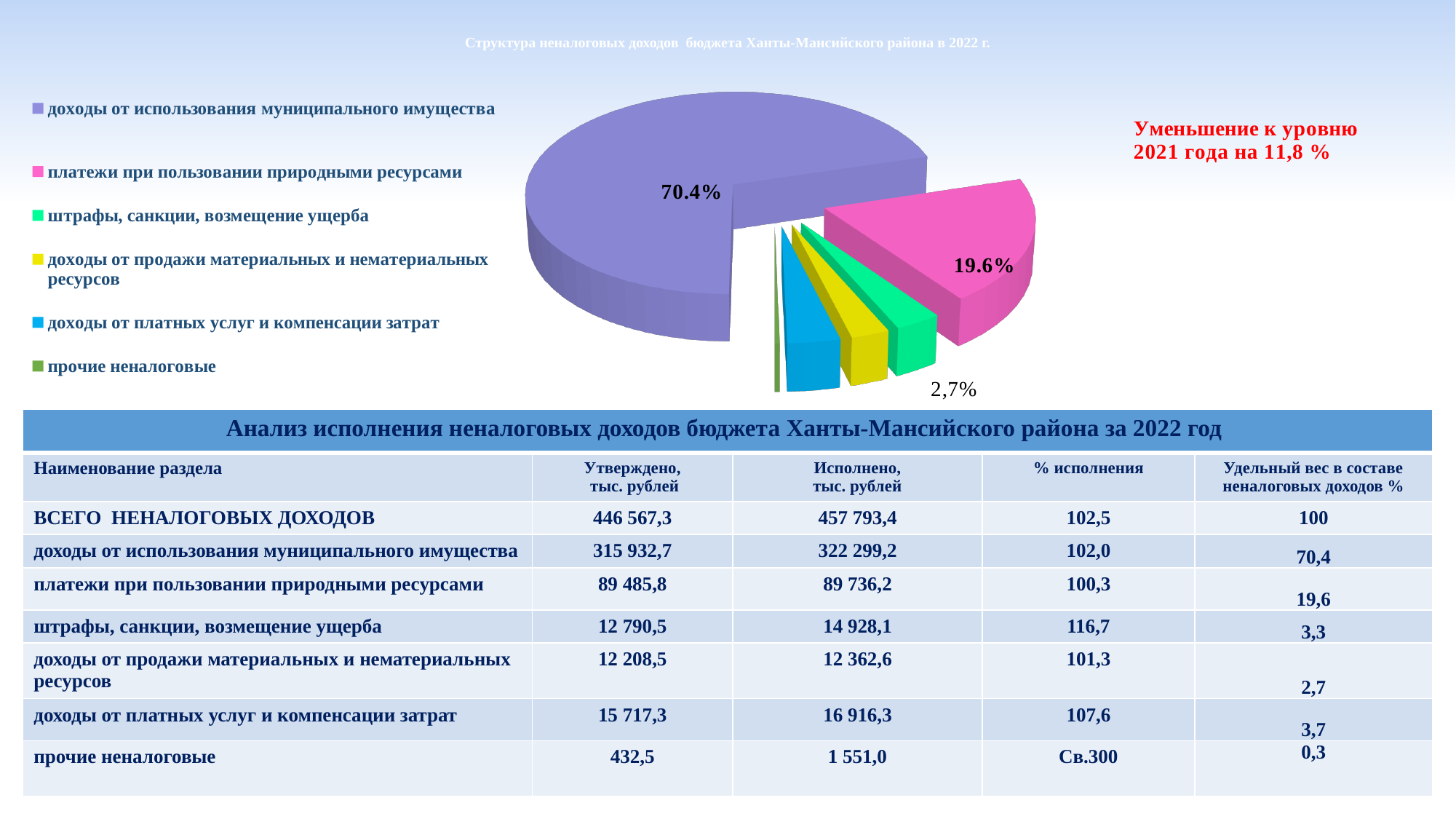
Which category has the smallest slice of the pie? прочие неналоговые Which slice is larger: доходы от использования муниципального имущества or платежи при пользовании природными ресурсами? доходы от использования муниципального имущества What colour is the slice for платежи при пользовании природными ресурсами? pink What share of the pie is labelled for доходы от использования муниципального имущества? 70.4% Which category has the largest slice of the pie? доходы от использования муниципального имущества How many categories does the pie chart's legend list? 6 Is the share for платежи при пользовании природными ресурсами greater or less than 50%? less What kind of chart is shown on the slide? pie chart What is the title of the pie chart? Структура неналоговых доходов бюджета Ханты-Мансийского района в 2022 г. By how many percentage points does the share of доходы от использования муниципального имущества exceed the share of платежи при пользовании природными ресурсами? 50.8% What share of the pie is labelled for платежи при пользовании природными ресурсами? 19.6%